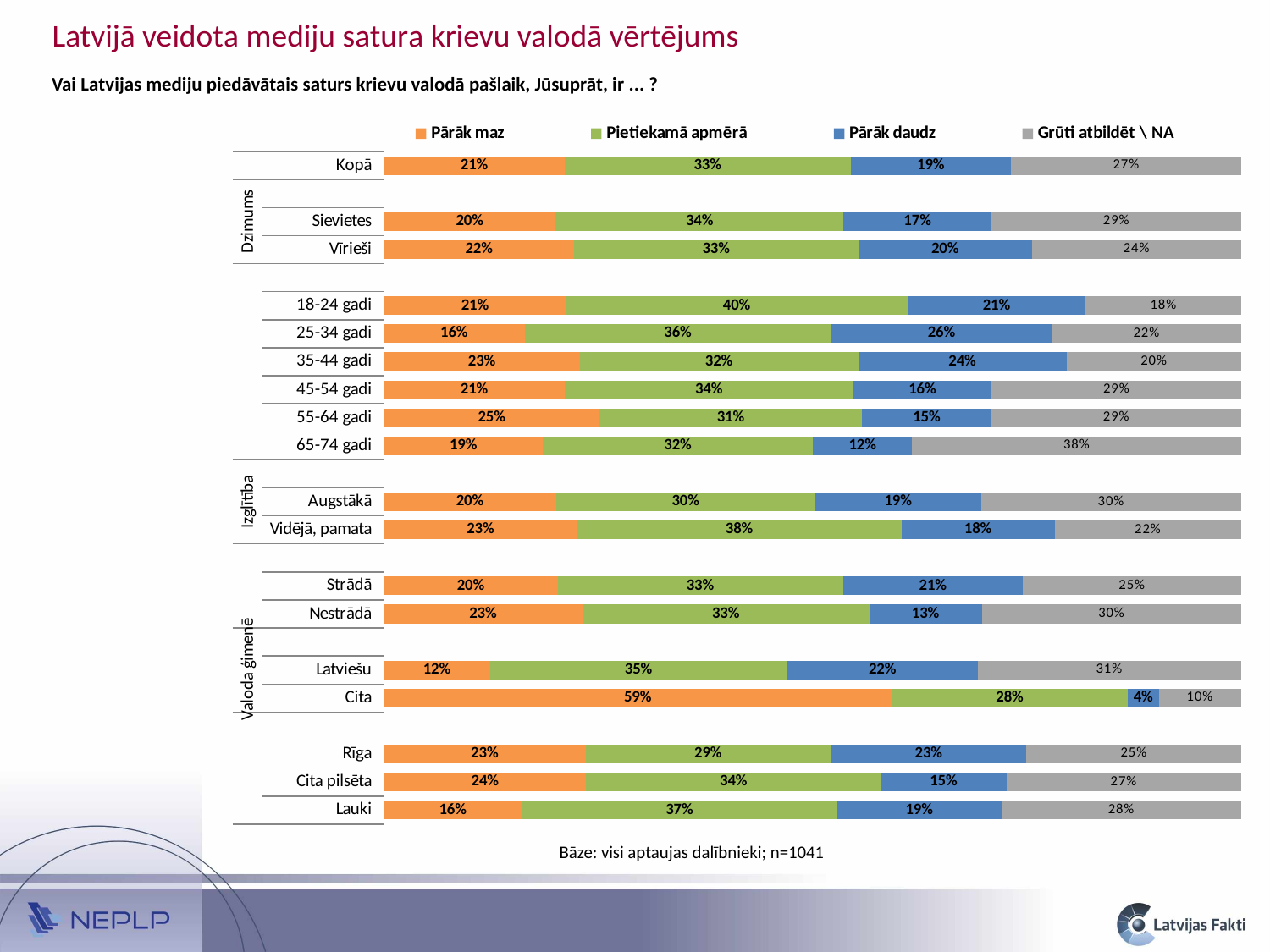
How many series does the legend list? 4 Which is larger: the "Pietiekamā apmērā" value for "Sievietes" or for "Vīrieši"? Sievietes Which legend entry is shown in orange? Pārāk maz What is the "Pietiekamā apmērā" value for "18-24 gadi"? 40% What is the "Pārāk maz" value for "Kopā"? 21% What is the "Grūti atbildēt \ NA" value for "65-74 gadi"? 38% What is the "Pārāk daudz" value for "Cita"? 4% Which category has the highest "Pārāk maz" value? Cita What kind of chart is shown on the slide? Stacked bar chart How many categories (rows) are plotted in the chart? 18 What is the difference between the "Pārāk daudz" values for "25-34 gadi" and "65-74 gadi"? 14% Which category has the lowest "Pārāk maz" value? Latviešu